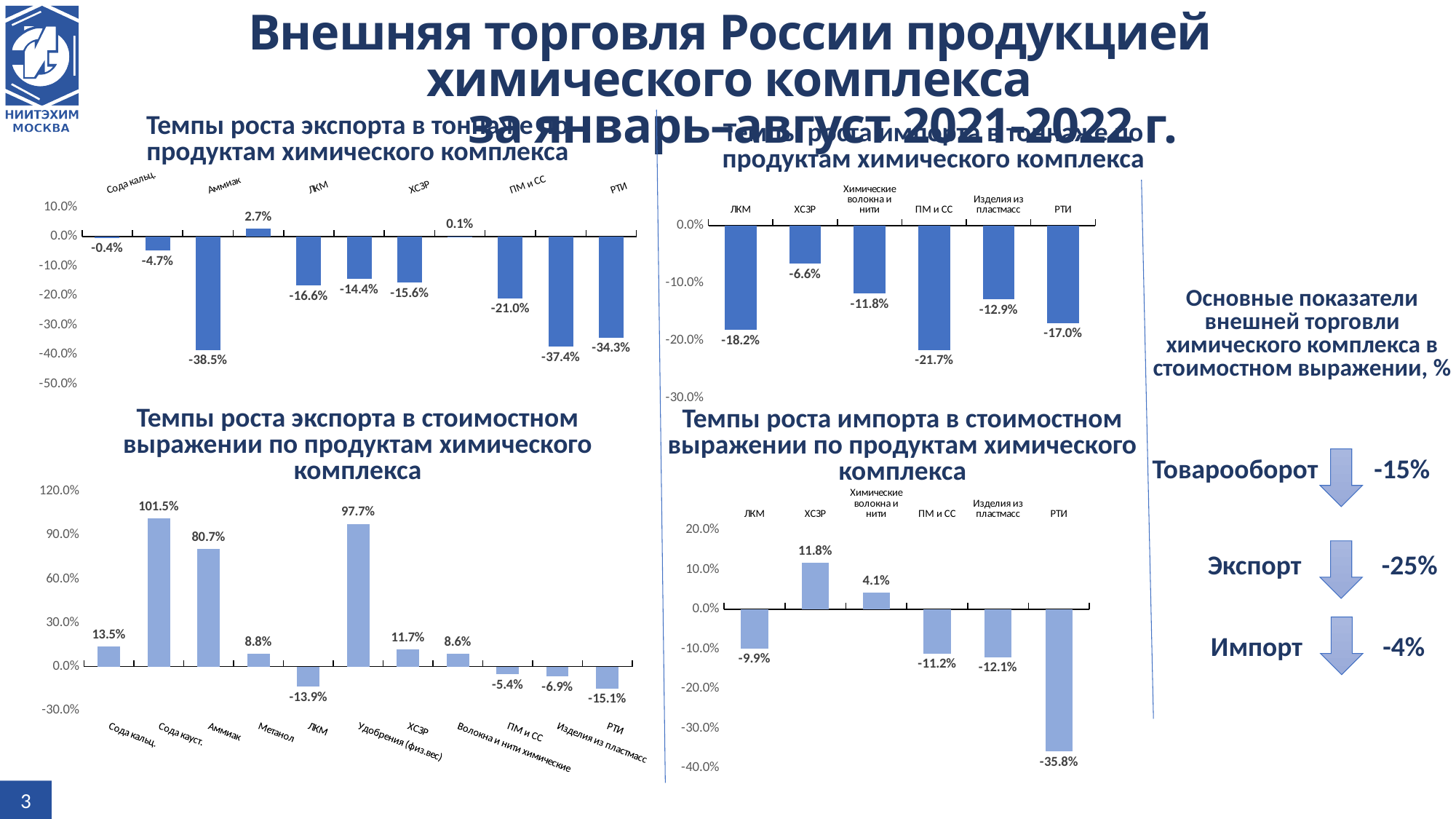
In the chart 'Темпы роста импорта в тоннаже по продуктам химического комплекса' (top right), which category has the highest value? ХСЗР In the chart 'Темпы роста экспорта в тоннаже по продуктам химического комплекса' (top left), what is the lowest value shown? -38.5% In the chart 'Темпы роста экспорта в стоимостном выражении по продуктам химического комплекса' (bottom left), which category has the lowest value? РТИ In the chart 'Темпы роста импорта в тоннаже по продуктам химического комплекса' (top right), what is the value for ПМ и СС? -21.7% In the chart 'Темпы роста экспорта в стоимостном выражении по продуктам химического комплекса' (bottom left), what is the value for Сода кауст.? 101.5% In the chart 'Темпы роста экспорта в стоимостном выражении по продуктам химического комплекса' (bottom left), what is the difference between the values for Сода кауст. and Удобрения (физ.вес)? 3.8% In the chart 'Темпы роста импорта в стоимостном выражении по продуктам химического комплекса' (bottom right), what is the difference between the values for ЛКМ and ПМ и СС? 1.3% In the chart 'Темпы роста импорта в тоннаже по продуктам химического комплекса' (top right), how many categories are plotted? 6 In the chart 'Темпы роста импорта в стоимостном выражении по продуктам химического комплекса' (bottom right), which is larger, the value for ХСЗР or the value for Химические волокна и нити? ХСЗР In the chart 'Темпы роста экспорта в стоимостном выражении по продуктам химического комплекса' (bottom left), how many categories are plotted? 11 What kind of chart is 'Темпы роста импорта в тоннаже по продуктам химического комплекса' (top right)? Bar chart In the chart 'Темпы роста импорта в стоимостном выражении по продуктам химического комплекса' (bottom right), what is the value for РТИ? -35.8%